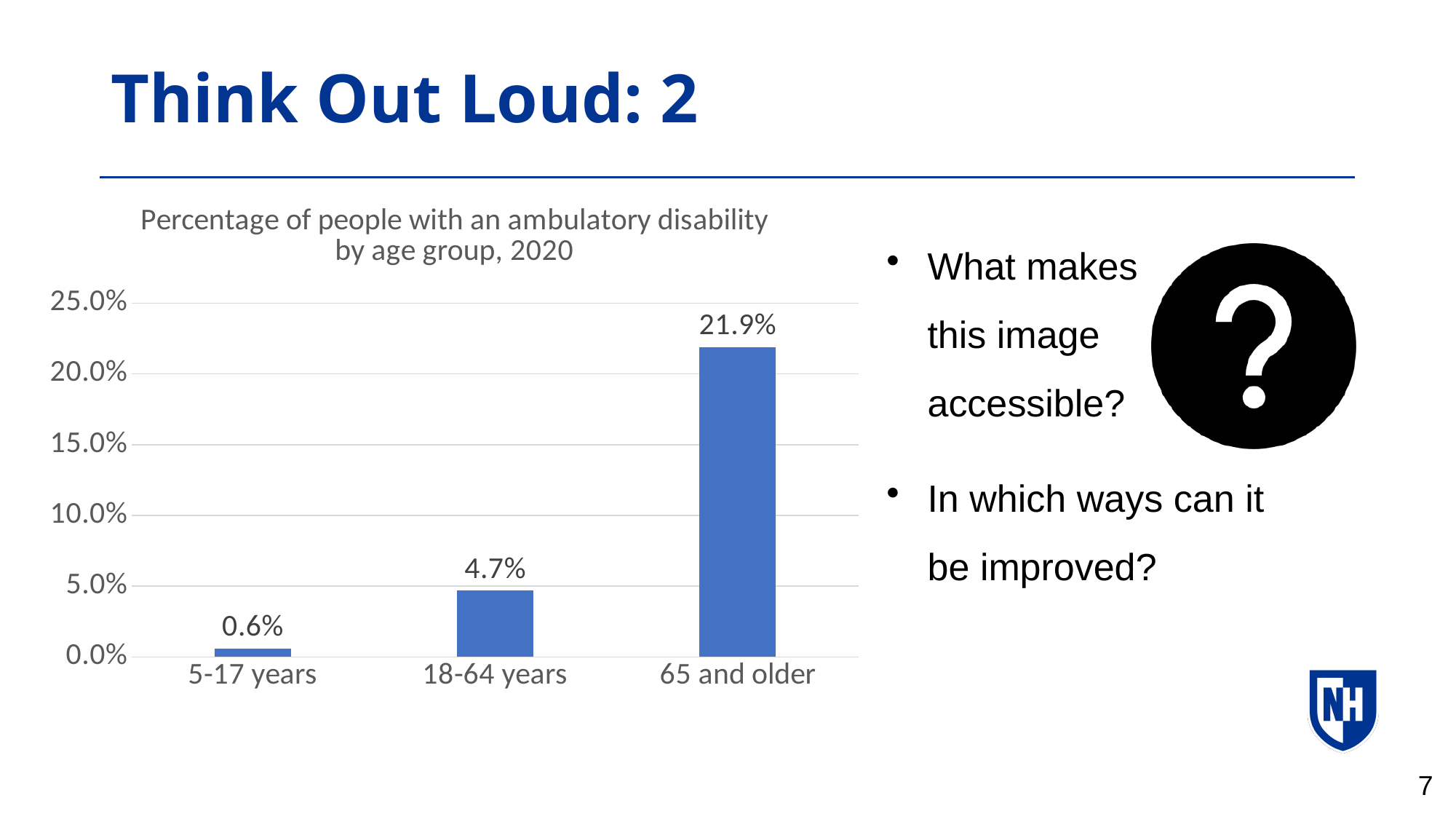
What is the percentage of people with an ambulatory disability in the 18-64 years age group? 4.7% What is the title of the chart? Percentage of people with an ambulatory disability by age group, 2020 Which has a higher percentage: 18-64 years or 5-17 years? 18-64 years What is the difference in percentage points between the 65 and older group and the 18-64 years group? 17.2% Which age group has the lowest percentage of people with an ambulatory disability? 5-17 years What is the percentage of people with an ambulatory disability in the 5-17 years age group? 0.6% What is the difference in percentage points between the 18-64 years group and the 5-17 years group? 4.1% How many age groups are shown in the chart? 3 Is the value for 65 and older greater or less than 20.0%? greater Which age group has the highest percentage of people with an ambulatory disability? 65 and older What kind of chart is shown on the slide? Bar chart What is the percentage of people with an ambulatory disability in the 65 and older age group? 21.9%